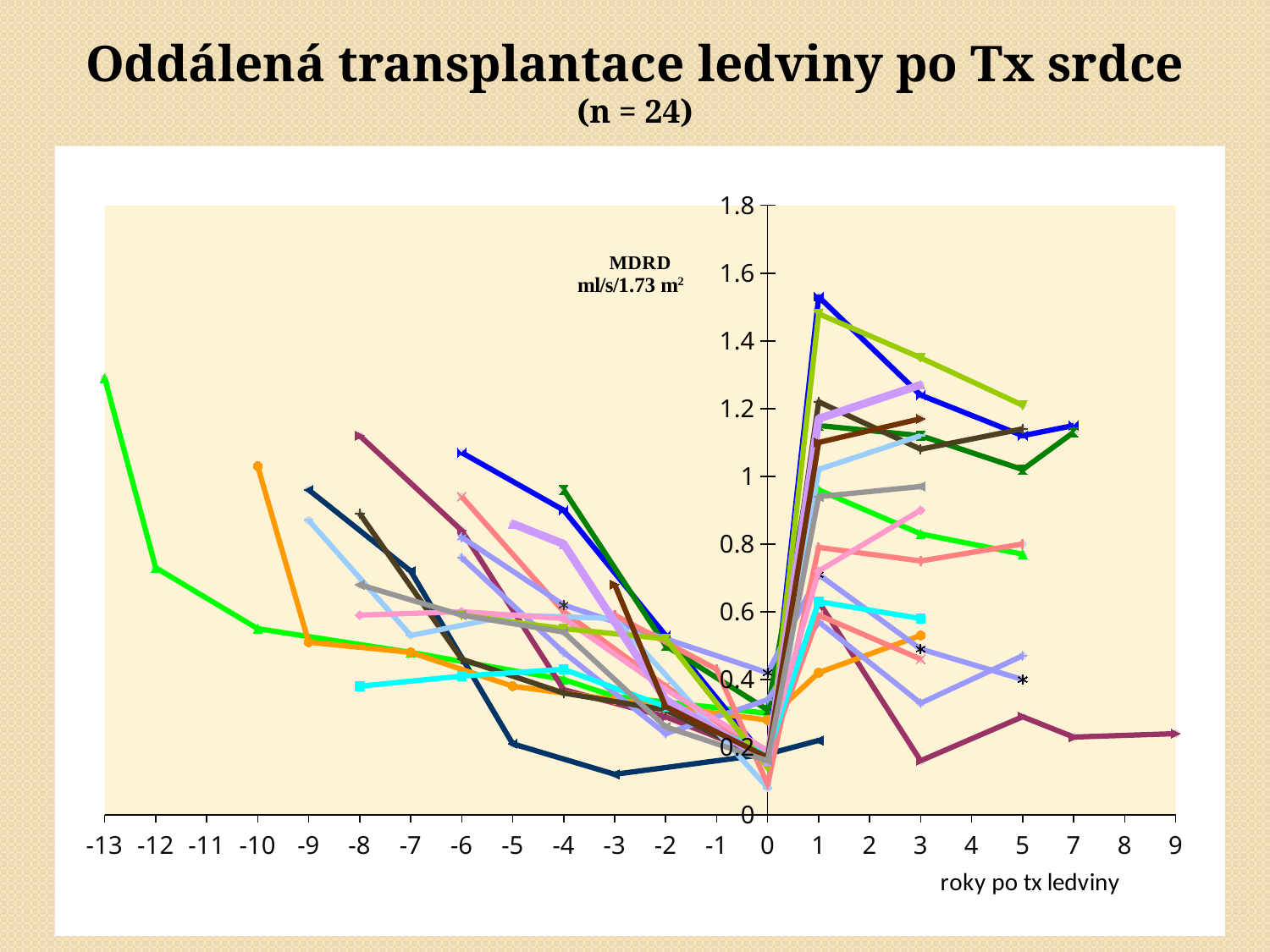
Do the plotted values generally rise or fall between year -13 and year 0 on the x axis? fall What is the lowest value shown on the x axis of the chart? -13 What is the highest value shown on the y axis of the chart? 1.8 What is the label of the x axis of the chart? roky po tx ledviny What kind of chart is shown on the slide? line chart Is the highest value plotted at year 0 greater or less than 0.6? less How many patients (n) does the chart represent according to the slide? 24 Is the highest value plotted at year 1 after kidney transplantation greater or less than 1.4? greater What is the title of the slide containing the chart? Oddálená transplantace ledviny po Tx srdce (n = 24) Is the value of the line starting at year -13 greater or less than 1.0 at that point? greater Do the plotted values generally rise or fall between year 0 and year 1 on the x axis? rise What is the highest value shown on the x axis of the chart? 9